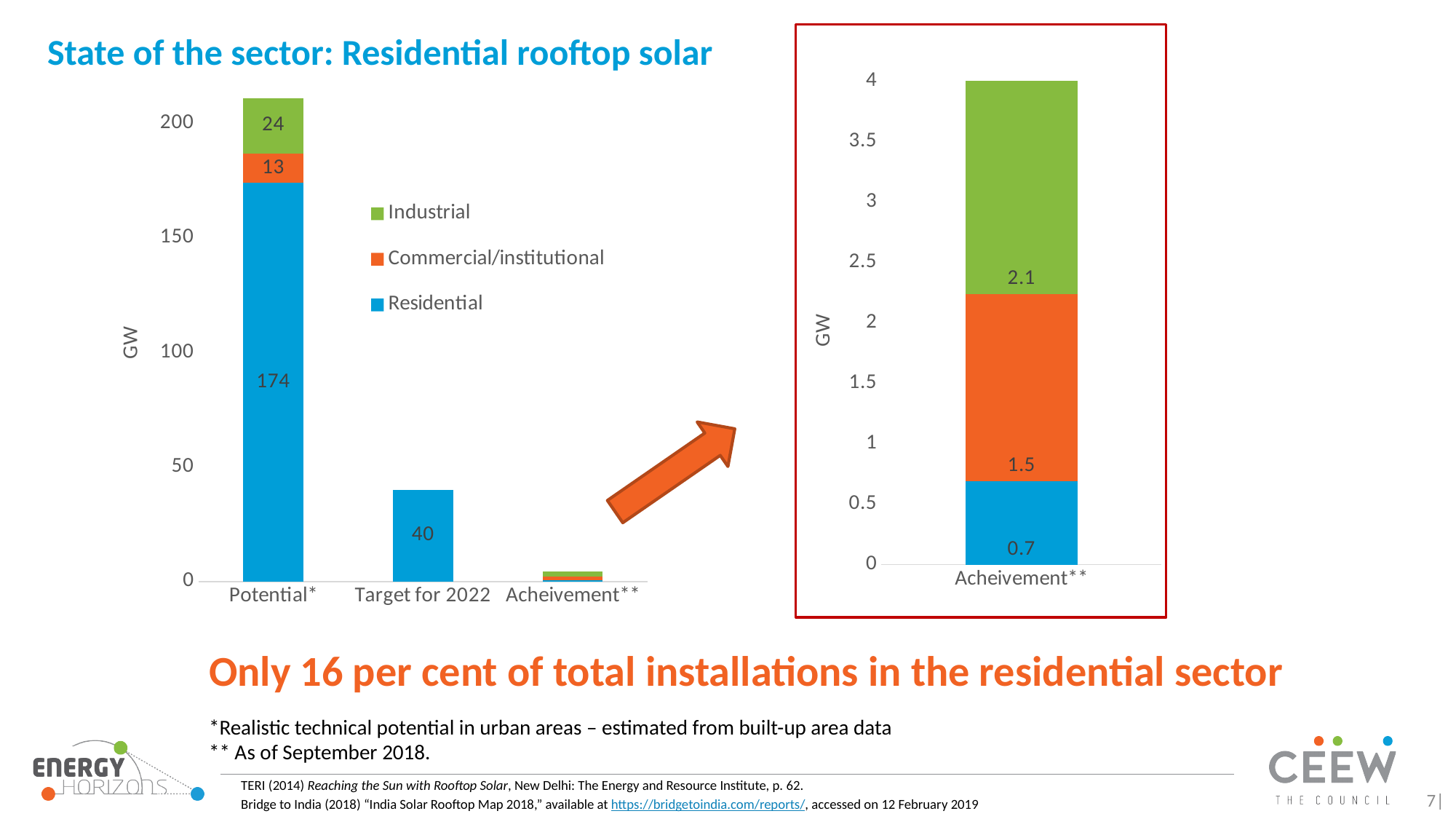
In the left chart, what is the Residential value for Potential*? 174 In the left chart, which category has the lowest total bar? Acheivement** In the right chart, what is the Commercial/institutional value for Acheivement**? 1.5 In the right chart, which segment is larger for Acheivement**: Residential or Industrial? Industrial In the left chart, what is the total of the stacked Potential* bar? 211 In the right chart, what is the total of the stacked Acheivement** bar? 4.3 In the left chart, what is the Industrial value for Potential*? 24 In the right chart, what is the Industrial value for Acheivement**? 2.1 How many series does the legend of the left chart list? 3 In the left chart, what is the difference between the Residential value for Potential* and the Target for 2022 value? 134 In the left chart, what is the Commercial/institutional value for Potential*? 13 In the left chart, what is the value shown for Target for 2022? 40